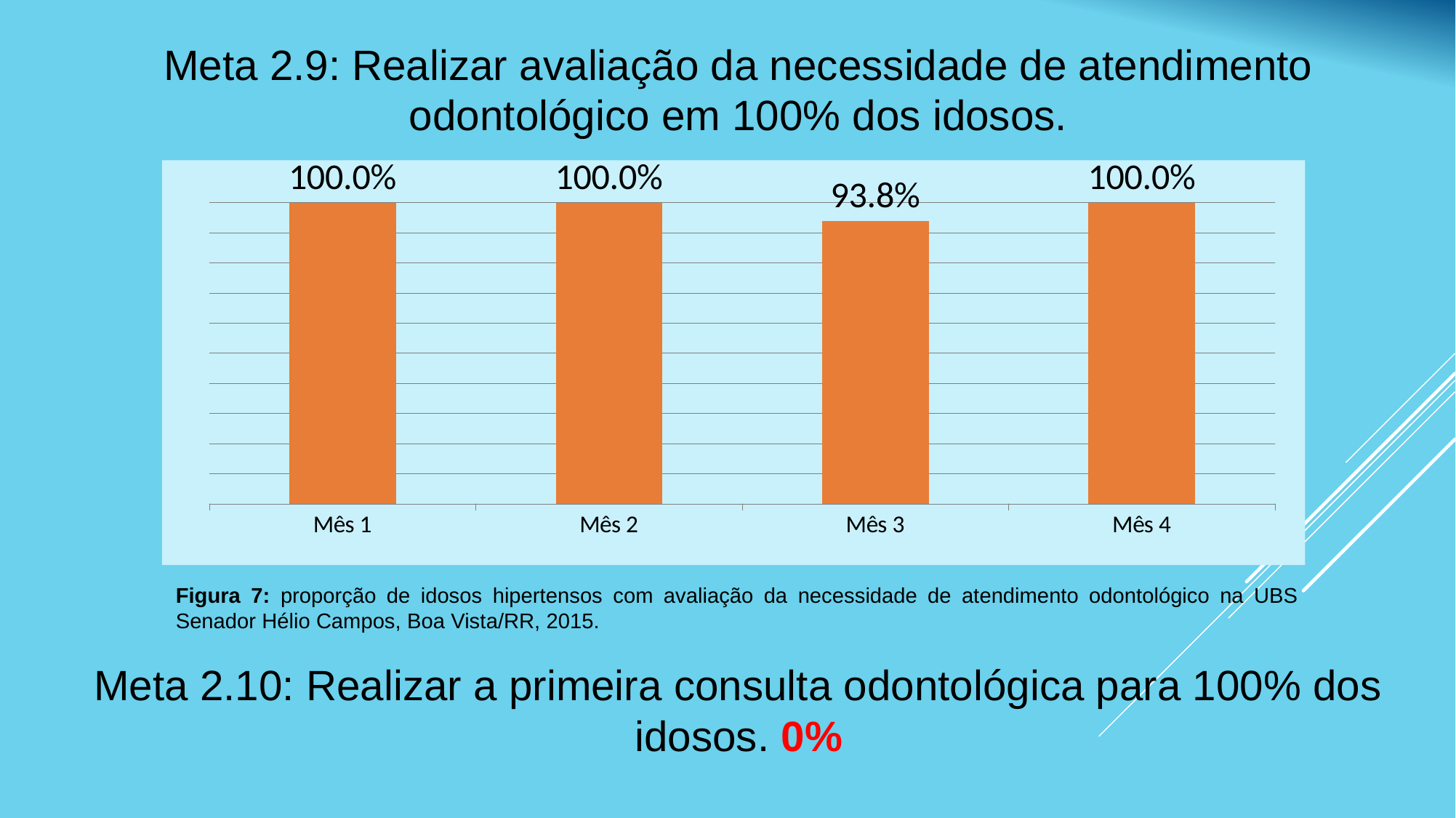
Which is larger, the value for Mês 3 or the value for Mês 4? Mês 4 What is the value for Mês 4? 100.0% How many months are shown on the x axis? 4 What is the value for Mês 1? 100.0% What is the figure number given in the caption below the chart? Figura 7 What is the difference between the values for Mês 2 and Mês 3? 6.2% What kind of chart is shown on the slide? Bar chart What is the value for Mês 3? 93.8% Which month has the lowest value? Mês 3 What colour are the bars in the chart? Orange Do the values for Mês 1 and Mês 2 have the same value? Yes